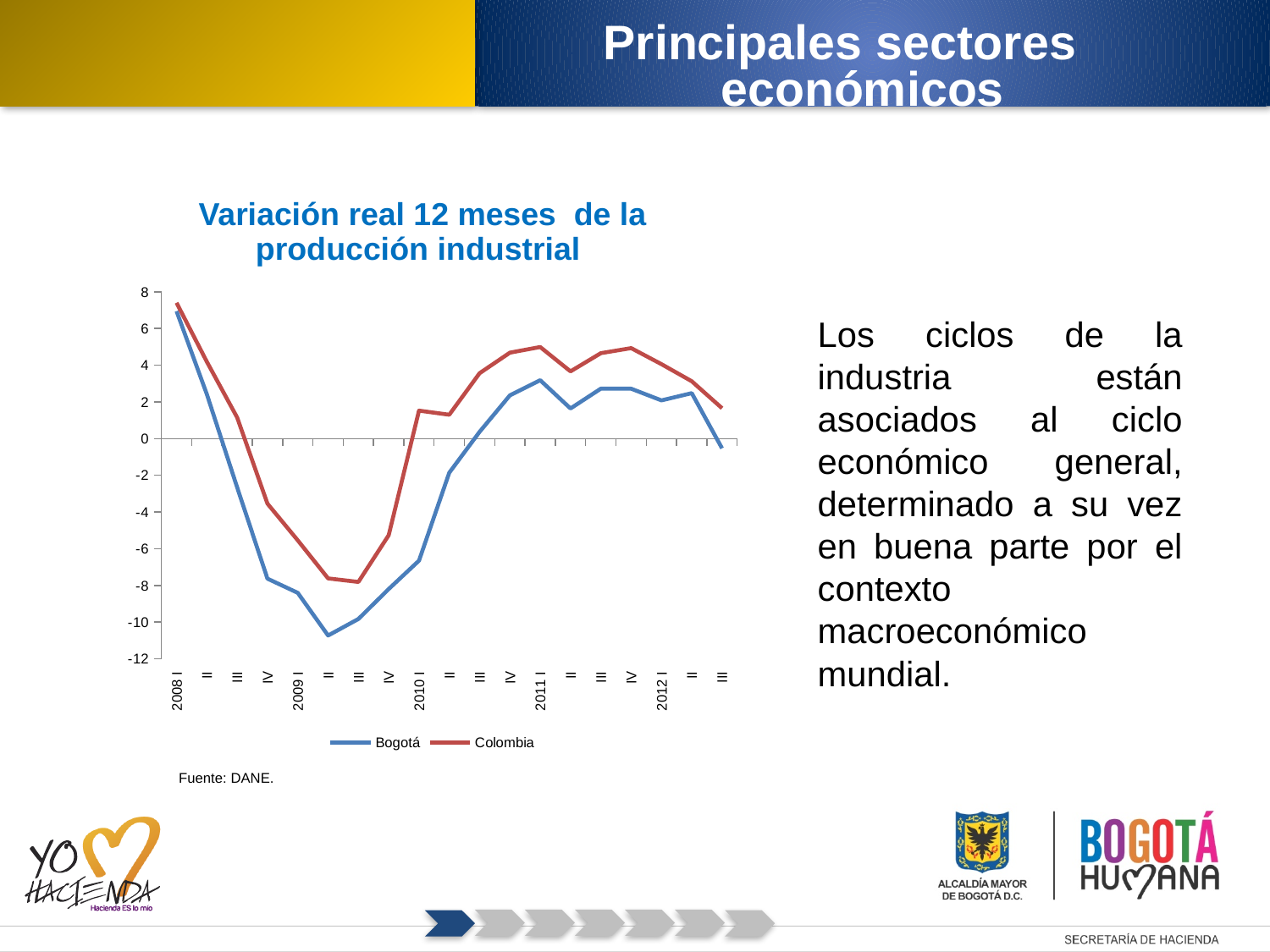
How many series does the legend of the chart list? 2 In which quarter does the Bogotá series reach its lowest value? 2009 II What is the title of the chart? Variación real 12 meses de la producción industrial Is the value for Bogotá in 2009 II greater or less than -10? less Is the value for Colombia in 2008 I greater or less than 6? greater Which two series are plotted in the chart? Bogotá and Colombia What kind of chart is shown on the slide? line chart Do the values for Bogotá rise or fall from 2008 I to 2009 II? fall How many quarterly data points are plotted for each series in the chart? 19 Is the value for Colombia in 2011 I greater or less than 4? greater In 2009 II, which series has the higher value, Bogotá or Colombia? Colombia